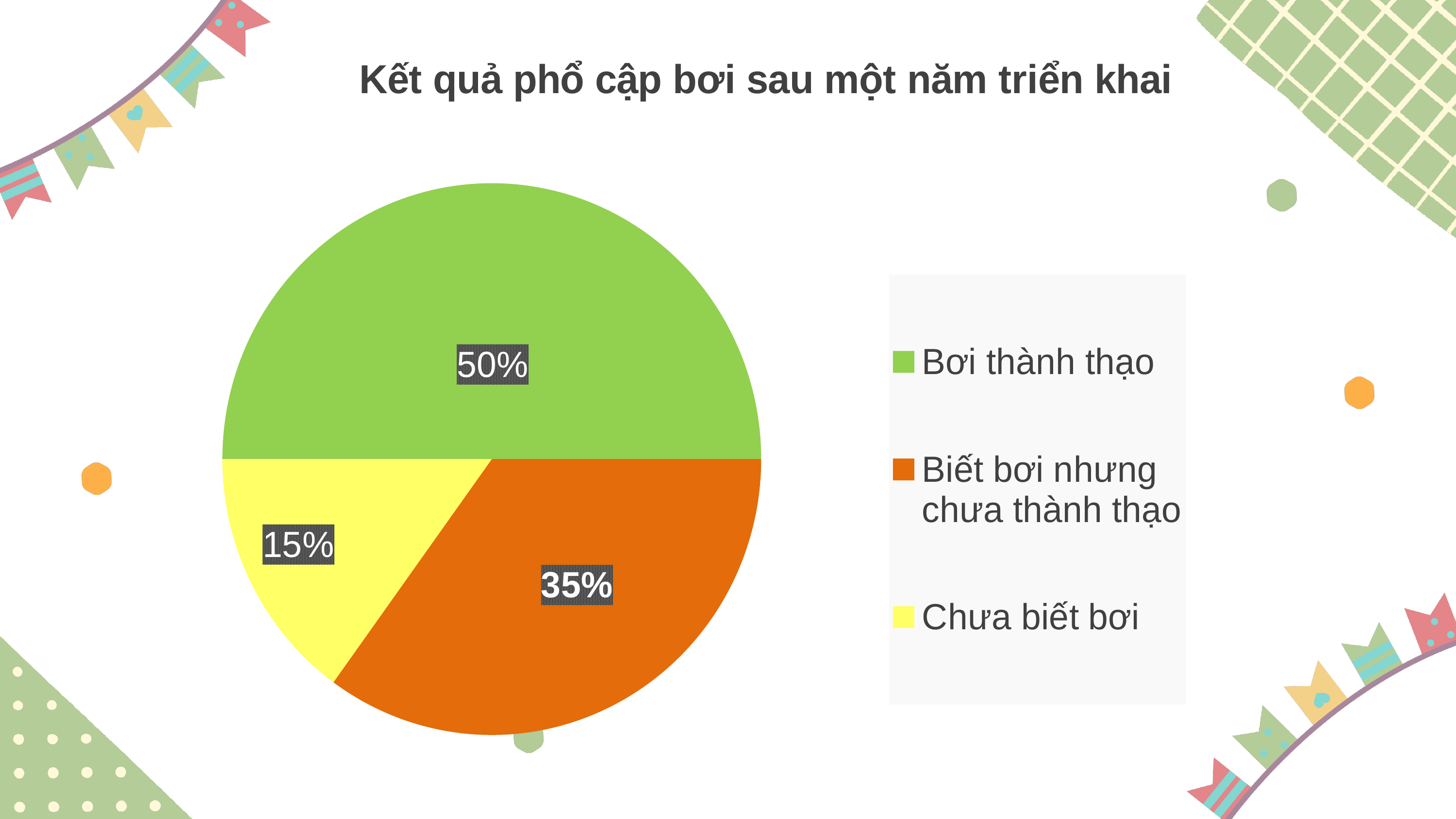
What is the difference in percentage points between "Bơi thành thạo" and "Chưa biết bơi"? 35% Which category has the largest slice of the pie? Bơi thành thạo What share of the pie does "Bơi thành thạo" represent? 50% What is the title of the chart? Kết quả phổ cập bơi sau một năm triển khai What share of the pie does "Biết bơi nhưng chưa thành thạo" represent? 35% What share of the pie does "Chưa biết bơi" represent? 15% What colour is the slice for "Chưa biết bơi"? Yellow How many slices does the pie chart have? 3 What is the difference in percentage points between "Biết bơi nhưng chưa thành thạo" and "Chưa biết bơi"? 20% Which category has the smallest slice of the pie? Chưa biết bơi What kind of chart is shown on the slide? Pie chart Which is larger: the slice for "Biết bơi nhưng chưa thành thạo" or the slice for "Chưa biết bơi"? Biết bơi nhưng chưa thành thạo